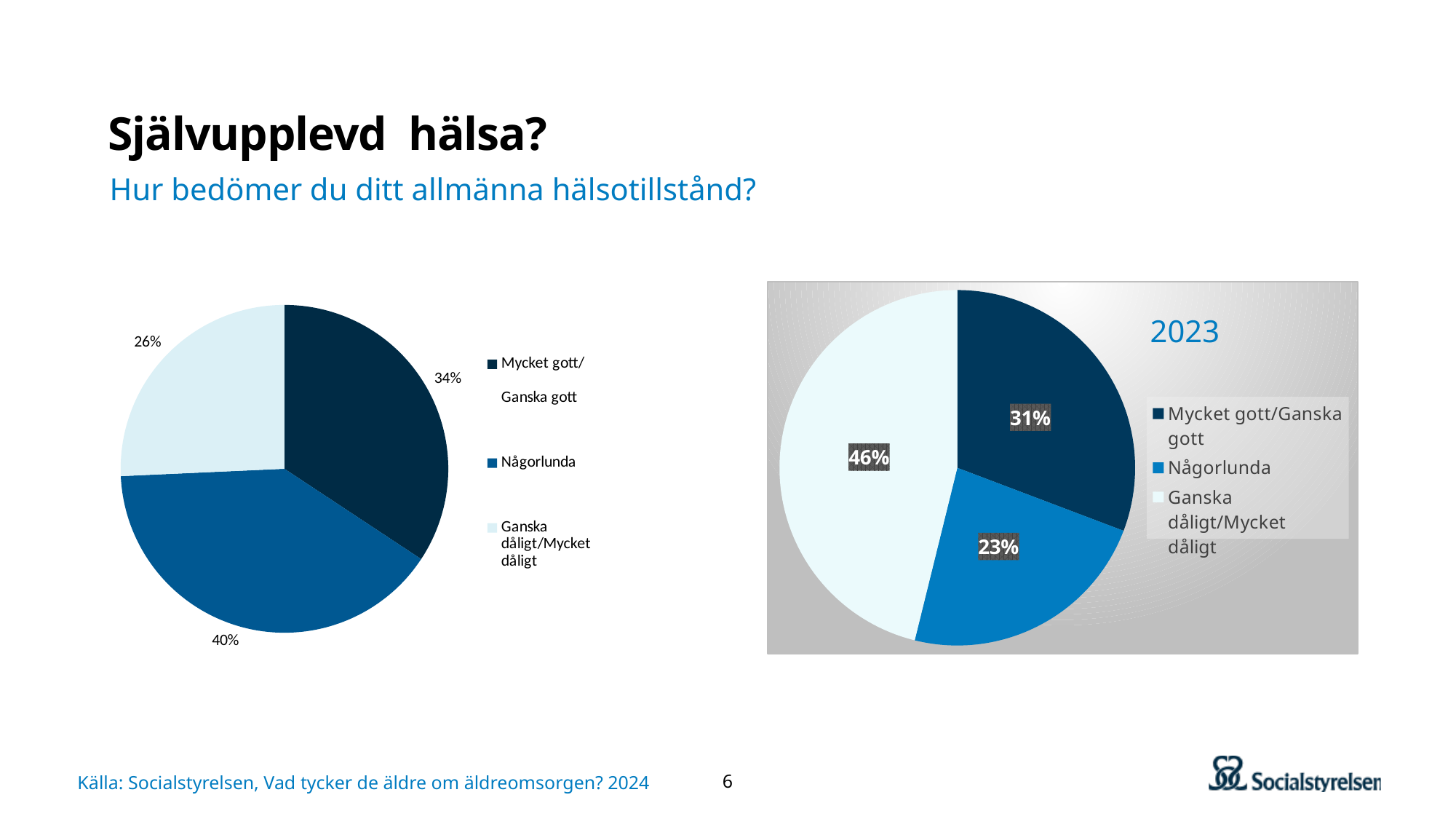
How many categories does the legend of the 2023 pie chart on the right list? 3 In the 2023 pie chart on the right of the slide, which is larger: Mycket gott/Ganska gott or Någorlunda? Mycket gott/Ganska gott What kind of chart is shown on the right of the slide? Pie chart In the pie chart on the left of the slide, which category has the largest slice? Någorlunda In the 2023 pie chart on the right of the slide, what share is labelled for Någorlunda? 23% In the pie chart on the left of the slide, which category has the smallest slice? Ganska dåligt/Mycket dåligt In the 2023 pie chart on the right of the slide, what share is labelled for Ganska dåligt/Mycket dåligt? 46% In the pie chart on the left of the slide, what share is labelled for Ganska dåligt/Mycket dåligt? 26% In the pie chart on the left of the slide, what share is labelled for Någorlunda? 40% In the pie chart on the left of the slide, what is the difference in percentage points between Någorlunda and Ganska dåligt/Mycket dåligt? 14 percentage points In the 2023 pie chart on the right of the slide, which category has the largest slice? Ganska dåligt/Mycket dåligt In the pie chart on the left of the slide, what share is labelled for Mycket gott/Ganska gott? 34%